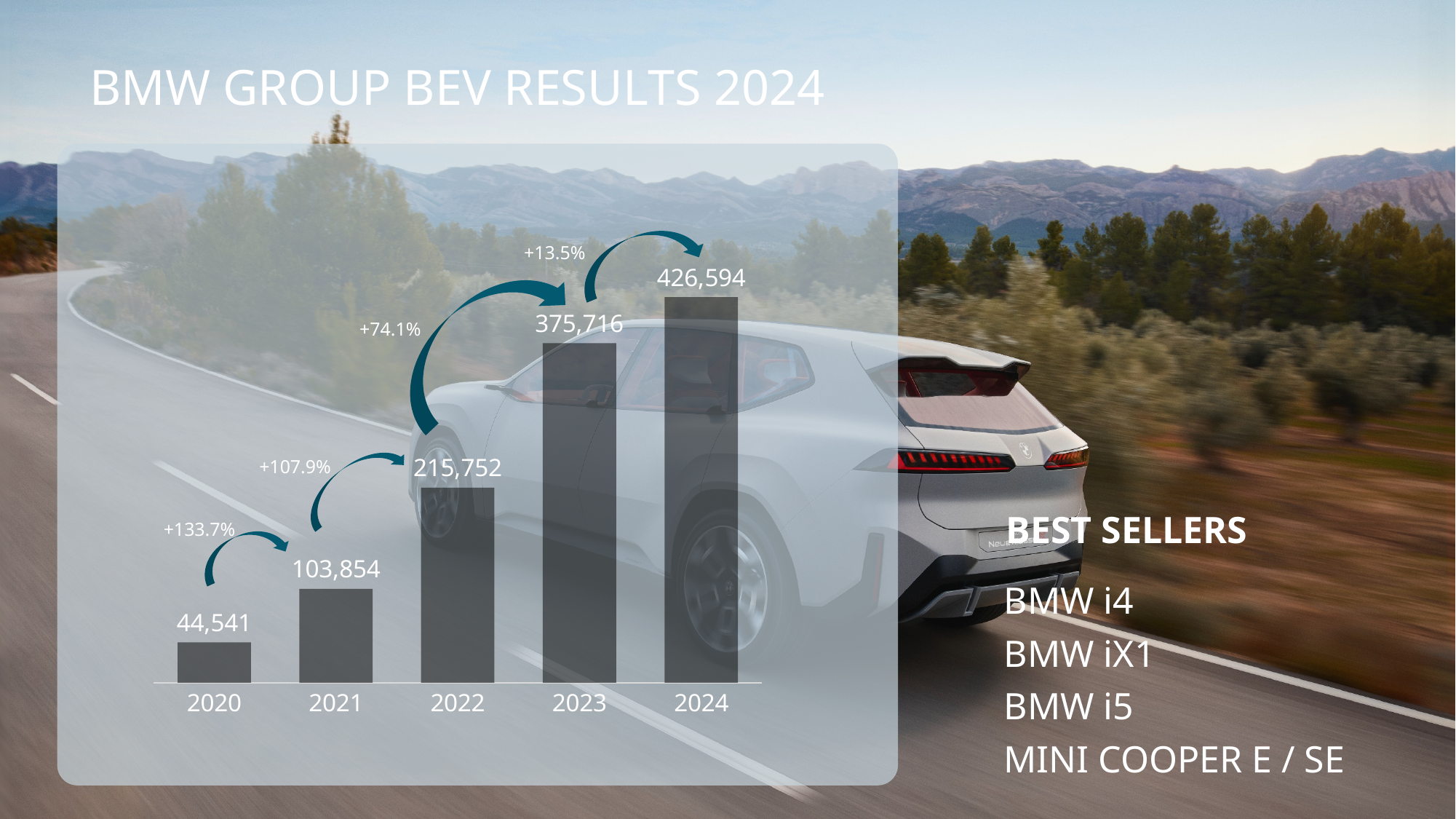
Which year has the highest value? 2024 How many years are shown on the x axis? 5 What is the difference between the values for 2021 and 2020? 59,313 What is the value for 2020? 44,541 Which is larger, the value for 2022 or the value for 2023? 2023 What is the difference between the values for 2024 and 2023? 50,878 What is the value for 2022? 215,752 What kind of chart is shown on the slide? bar chart Which year has the lowest value? 2020 What percentage change is labelled between 2021 and 2022? +107.9% Do the values rise or fall from 2020 to 2024? rise What is the value for 2024? 426,594